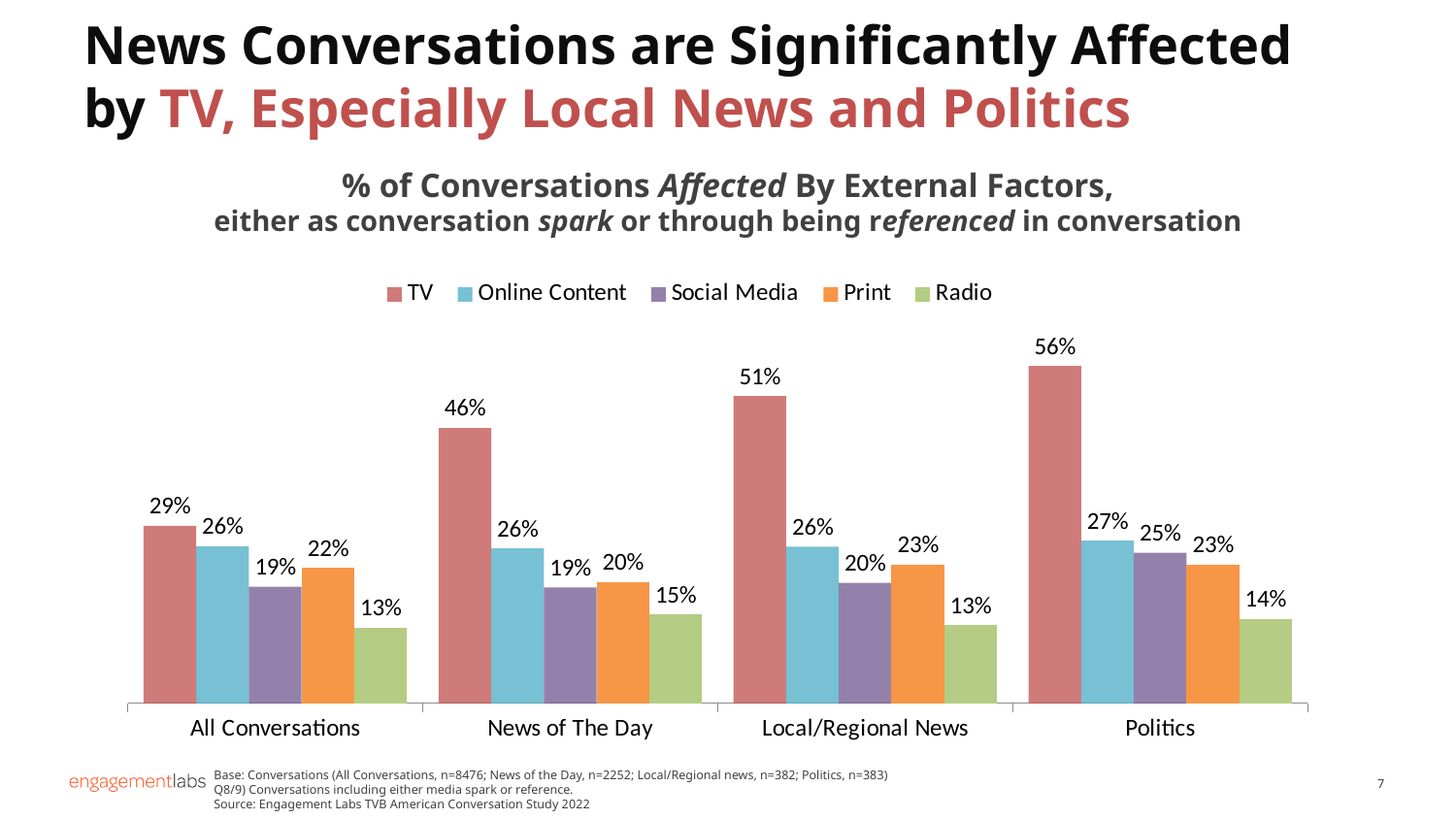
What is the difference between the TV value for Politics and the TV value for All Conversations? 27% What is the value for TV in the Politics category? 56% What is the value for Print in the Local/Regional News category? 23% What kind of chart is shown on the slide? Bar chart Which category has the highest TV value? Politics What is the value for Radio in the All Conversations category? 13% Do the TV values rise or fall moving from All Conversations to Politics along the x axis? Rise Which series has the lowest value in the News of The Day category? Radio Which is larger: Social Media for Politics or Social Media for All Conversations? Social Media for Politics Which series is shown in orange in the legend? Print How many series does the legend list? 5 How many categories are shown on the x axis? 4